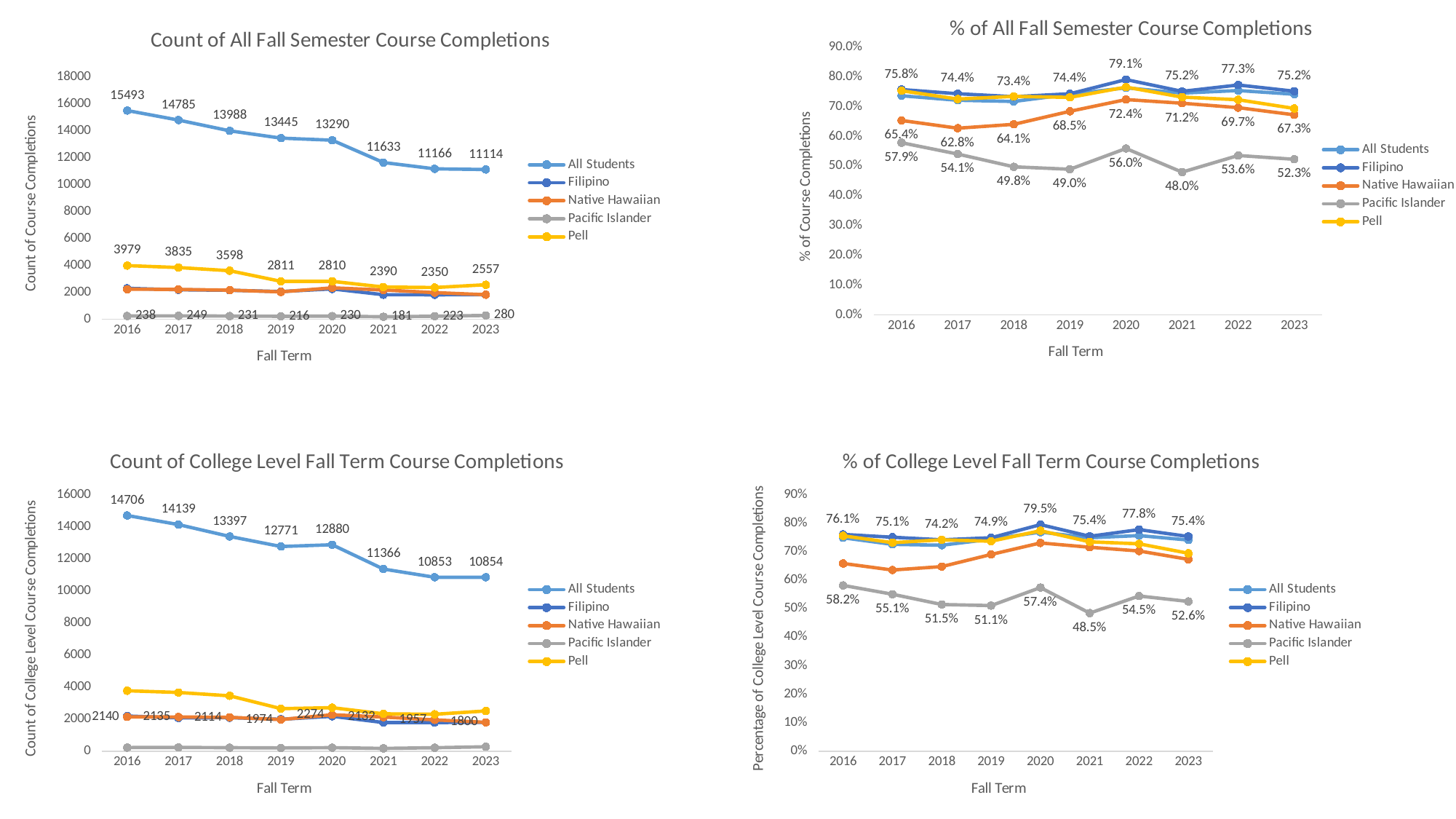
In the 'Count of College Level Fall Term Course Completions' chart, is the All Students value for 2022 larger or smaller than the value for 2019? smaller In the 'Count of All Fall Semester Course Completions' chart, what is the difference between the All Students values for 2016 and 2023? 4379 In the '% of College Level Fall Term Course Completions' chart, what is the Pacific Islander value for 2020? 57.4% In the 'Count of All Fall Semester Course Completions' chart, in which year is the Pacific Islander count lowest? 2021 In the '% of All Fall Semester Course Completions' chart, in which year is the Pacific Islander percentage highest? 2016 In the 'Count of College Level Fall Term Course Completions' chart, what is the All Students value for 2020? 12880 In the '% of All Fall Semester Course Completions' chart, what is the Pacific Islander value for 2021? 48.0% In the 'Count of All Fall Semester Course Completions' chart, what is the Pell value for 2019? 2811 How many series does the legend of the '% of All Fall Semester Course Completions' chart list? 5 In the 'Count of All Fall Semester Course Completions' chart, what is the value for All Students in 2016? 15493 What type of chart is the '% of College Level Fall Term Course Completions' chart? line chart In the 'Count of All Fall Semester Course Completions' chart, does the All Students line generally rise or fall from 2016 to 2023? fall